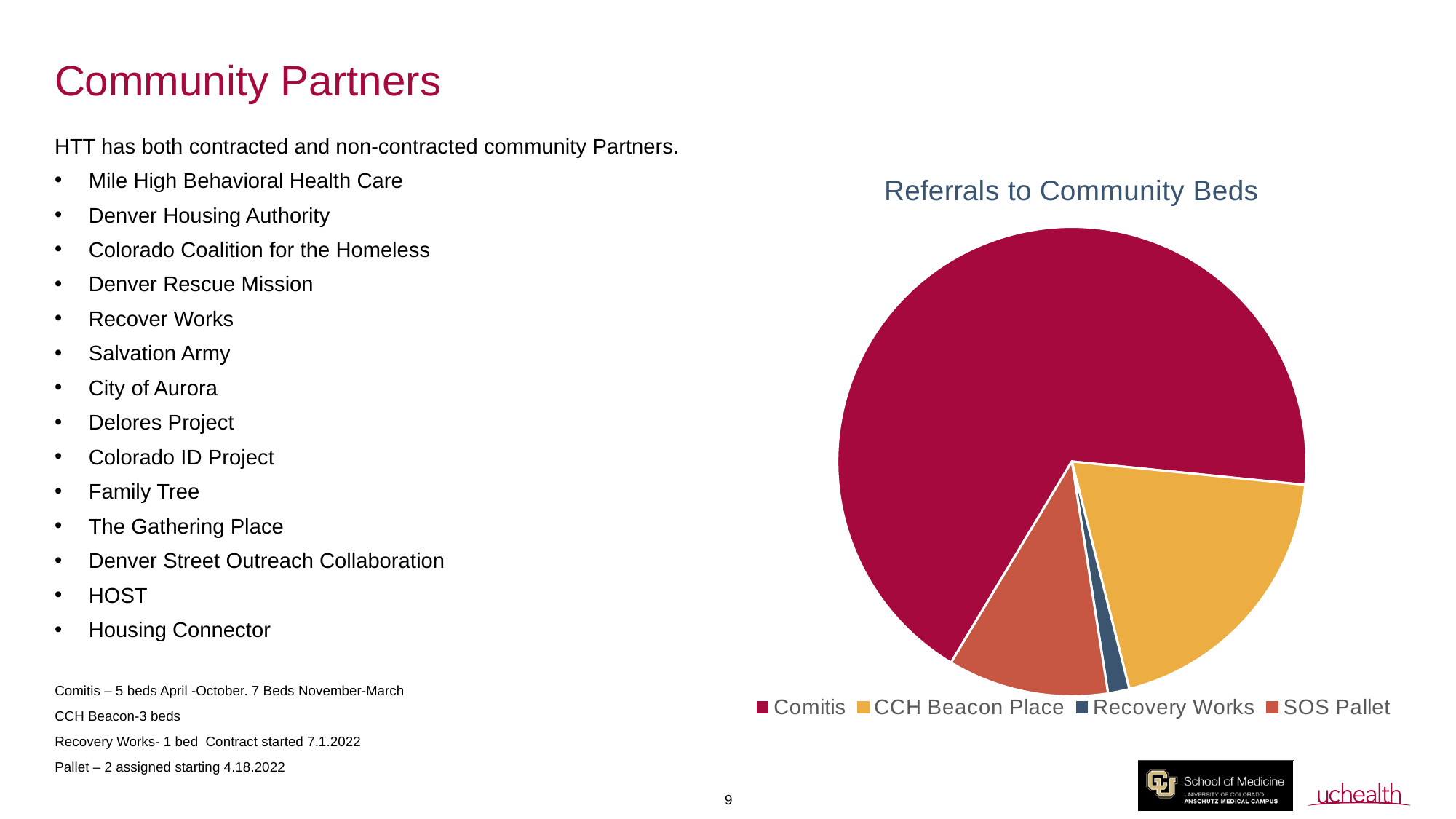
What is the title of the chart? Referrals to Community Beds Which slice is larger, CCH Beacon Place or SOS Pallet? CCH Beacon Place Which slice is larger, Comitis or CCH Beacon Place? Comitis Which slice is larger, SOS Pallet or Recovery Works? SOS Pallet Which category has the largest slice of the pie? Comitis How many slices does the pie chart have? 4 How many entries does the chart legend list? 4 What kind of chart is shown on the slide? pie chart Which category is shown in the yellow slice? CCH Beacon Place Which category has the smallest slice of the pie? Recovery Works